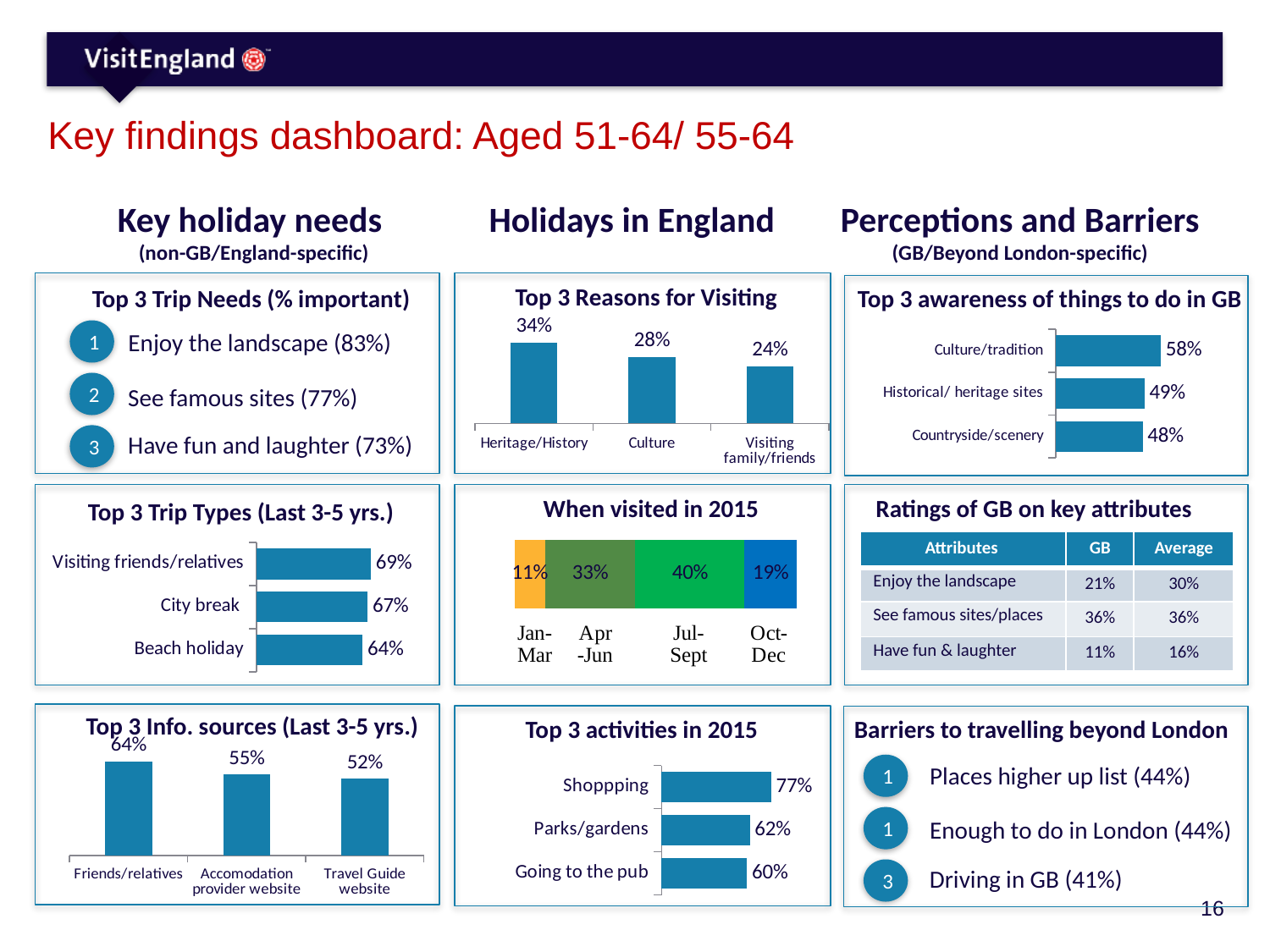
In the 'Top 3 awareness of things to do in GB' chart, which is larger, Culture/tradition or Countryside/scenery? Culture/tradition In the 'When visited in 2015' chart, how many time periods are shown? 4 In the 'Top 3 Info. sources (Last 3-5 yrs.)' chart, what is the value for Travel Guide website? 52% In the 'Top 3 Info. sources (Last 3-5 yrs.)' chart, what is the difference between Friends/relatives and Accomodation provider website? 9% In the 'Top 3 Trip Types (Last 3-5 yrs.)' chart, which trip type has the highest value? Visiting friends/relatives In the 'Top 3 activities in 2015' chart, what is the value for Going to the pub? 60% In the 'Top 3 Trip Types (Last 3-5 yrs.)' chart, what is the value for City break? 67% In the 'Top 3 activities in 2015' chart, what kind of chart is used? Bar chart In the 'When visited in 2015' chart, what is the value for Jul-Sept? 40% In the 'Top 3 Reasons for Visiting' chart, what is the value for Culture? 28% In the 'Top 3 Reasons for Visiting' chart, which reason has the lowest value? Visiting family/friends In the 'Top 3 awareness of things to do in GB' chart, what is the value for Historical/ heritage sites? 49%